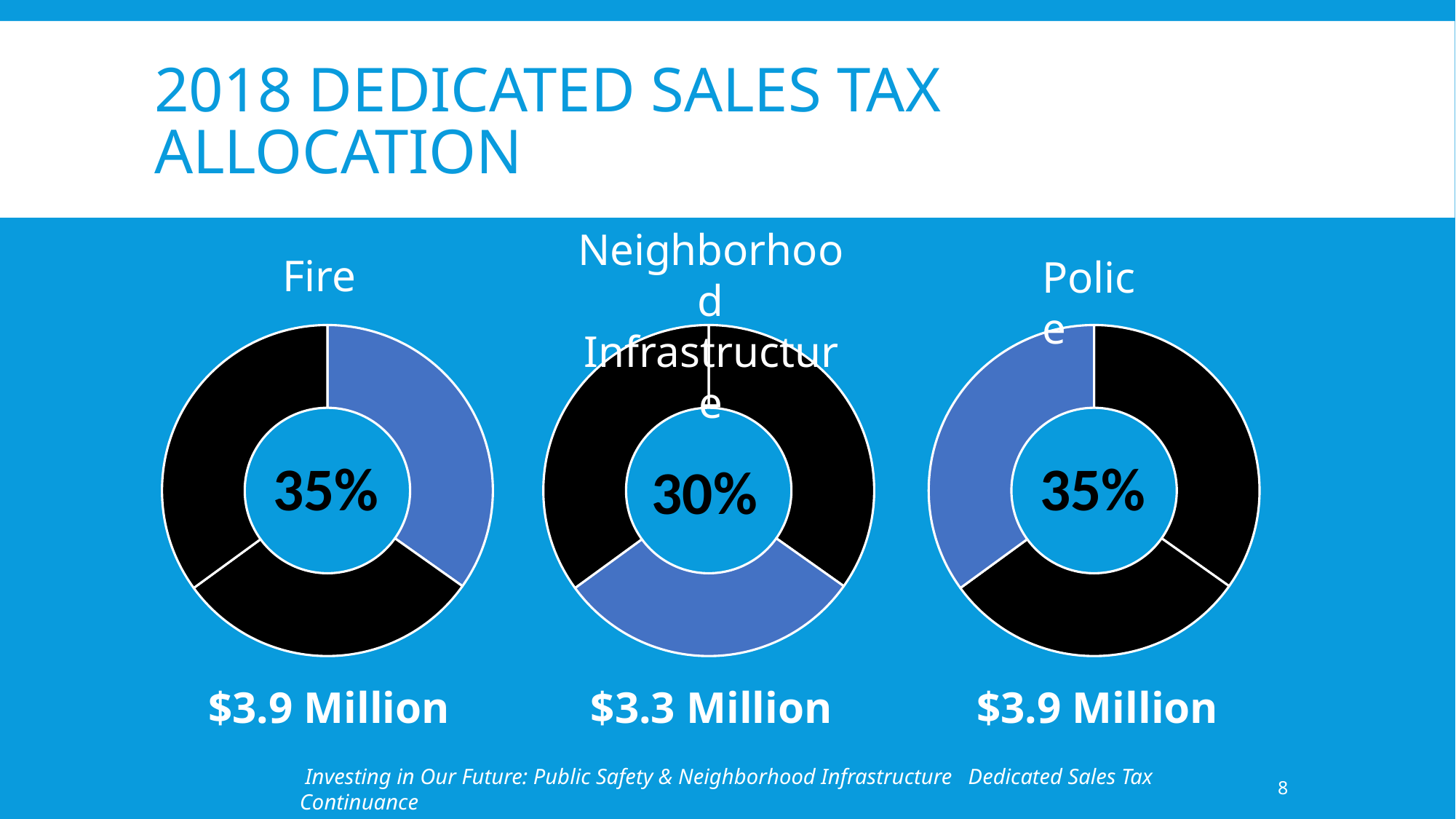
What dollar amount is printed below the Neighborhood Infrastructure chart? $3.3 Million What dollar amount is printed below the Police chart? $3.9 Million What is the difference in percentage points between the Fire share and the Neighborhood Infrastructure share? 5 percentage points How many donut charts are shown on the slide? 3 What kind of chart is used to show the Fire allocation? Donut (pie) chart In the Police chart, what percentage is shown in the centre of the donut? 35% Which receives a larger dollar amount, Fire or Neighborhood Infrastructure? Fire In the Neighborhood Infrastructure chart, what percentage is shown in the centre of the donut? 30% Across the three charts, which category has the lowest percentage share? Neighborhood Infrastructure What dollar amount is printed below the Fire chart? $3.9 Million What is the difference between the Police dollar amount and the Neighborhood Infrastructure dollar amount? $0.6 Million In the Fire chart, what percentage is shown in the centre of the donut? 35%